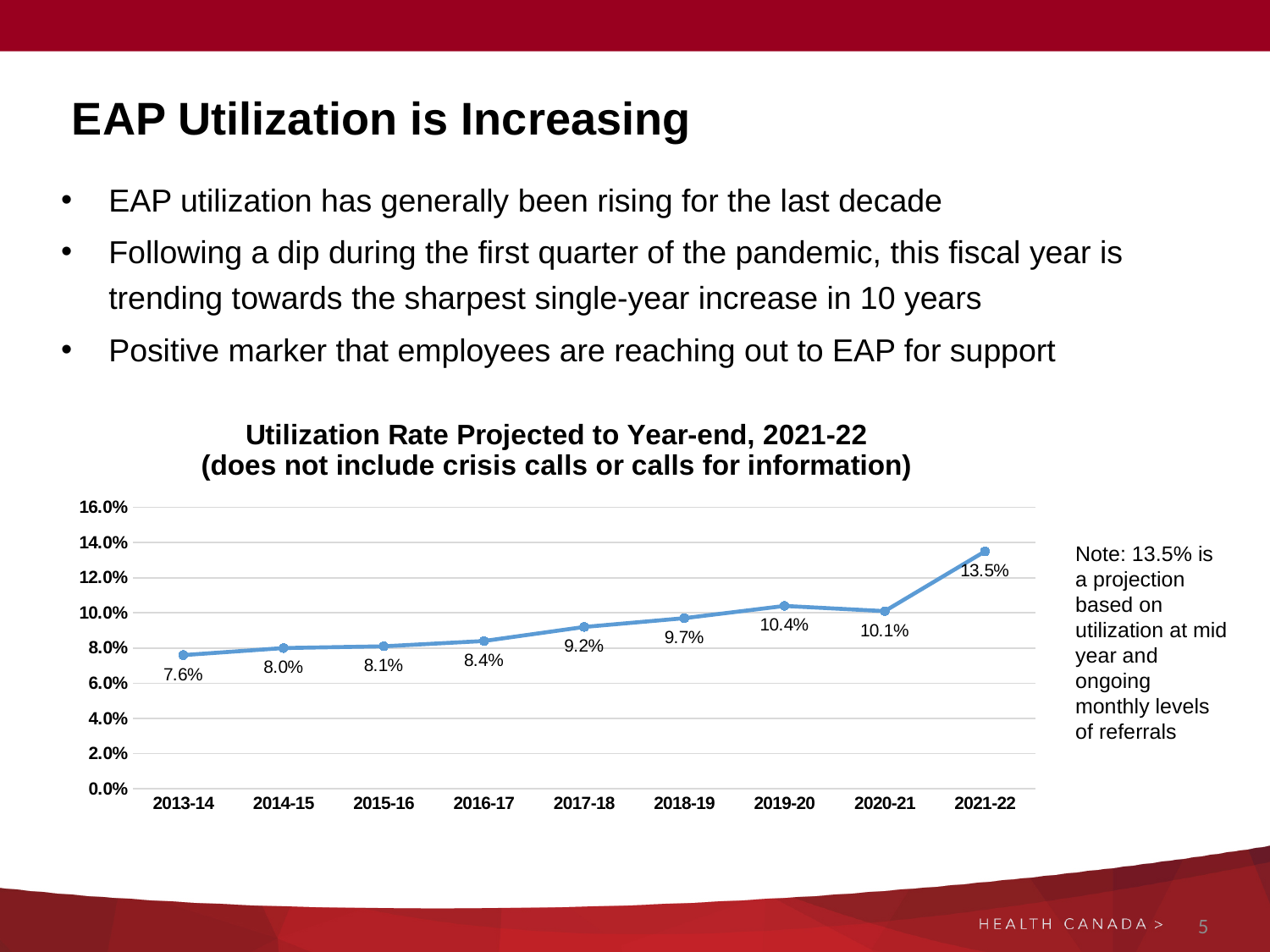
Does the utilization rate generally rise or fall from 2013-14 to 2021-22? rise What is the utilization rate for 2013-14? 7.6% What is the difference between the utilization rates for 2021-22 and 2020-21? 3.4% Which is larger, the utilization rate for 2019-20 or for 2020-21? 2019-20 What is the utilization rate for 2019-20? 10.4% What kind of chart is shown on the slide? line chart Is the utilization rate for 2017-18 greater or less than 10.0%? less What is the projected utilization rate for 2021-22? 13.5% Which fiscal year has the highest utilization rate? 2021-22 Which fiscal year has the lowest utilization rate? 2013-14 What is the title of the chart? Utilization Rate Projected to Year-end, 2021-22 (does not include crisis calls or calls for information) How many fiscal years are plotted on the chart? 9